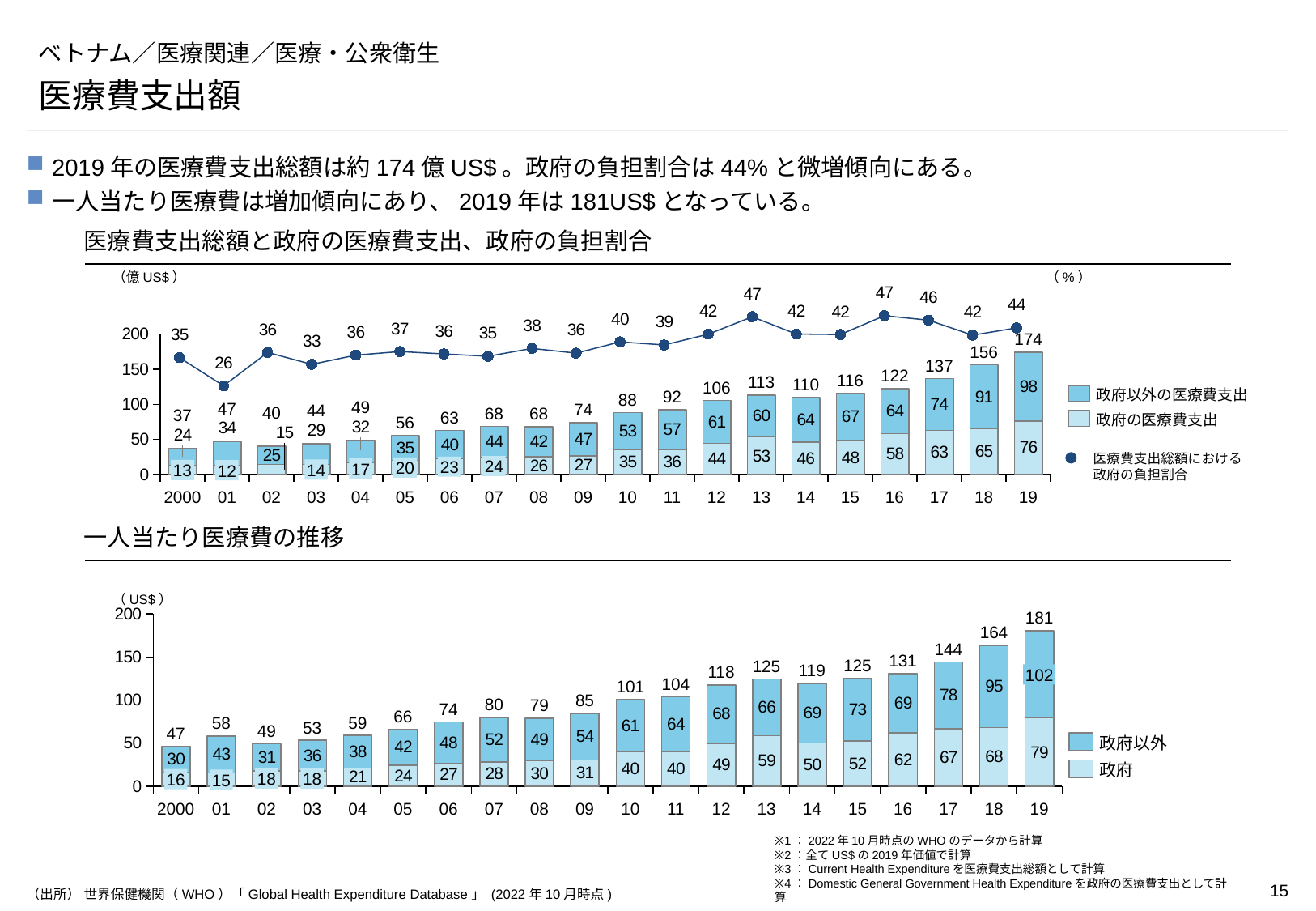
In the bottom chart, what is the total per-capita health expenditure for 2019? 181 In the bottom chart, what is the 政府 value for 2013? 59 In the bottom chart, which year has the lowest total per-capita health expenditure? 2000 In the top chart, in which year is the 政府の負担割合 line at its lowest? 2001 In the top chart, how many years are shown on the x axis? 20 In the top chart, what is the difference between the total health expenditure in 2019 and in 2018? 18 In the top chart, what is the value of 政府の医療費支出 for 2019? 76 In the bottom chart, is the 政府以外 value larger in 2017 or in 2016? 2017 In the top chart, how many series does the legend list? 3 What kind of chart is the bottom chart (一人当たり医療費の推移)? Stacked bar chart In the top chart (医療費支出総額と政府の医療費支出、政府の負担割合), what is the total health expenditure labeled for 2019? 174 In the top chart, what is the 政府の負担割合 value for 2013? 47